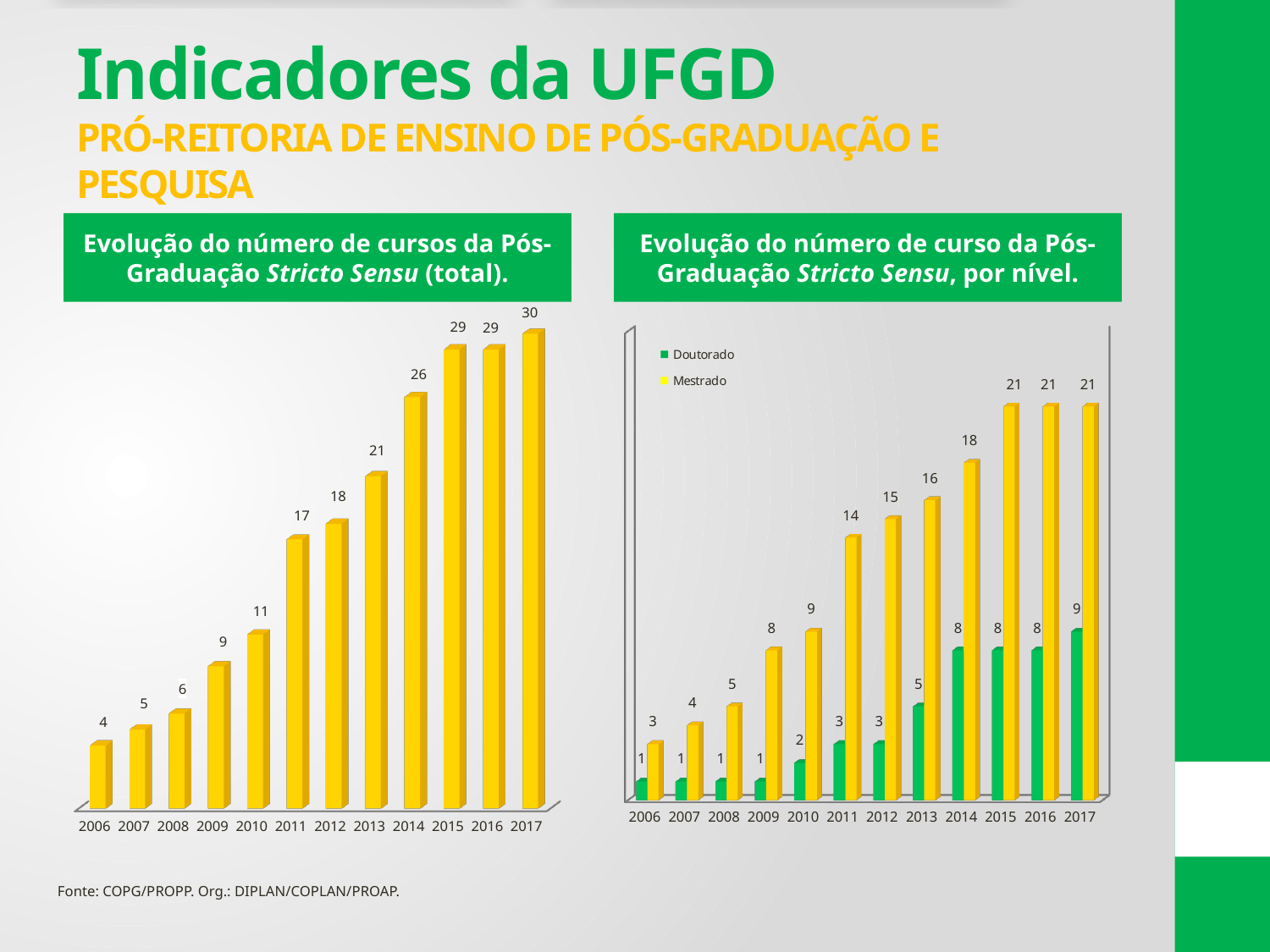
In the left chart (total courses), which year has the lowest value? 2006 In the right chart (por nível), how many series does the legend list? 2 In the left chart (total courses), what is the difference between the values for 2017 and 2006? 26 What type of chart is the left chart (total courses)? bar chart In the left chart (Evolução do número de cursos da Pós-Graduação Stricto Sensu (total)), what is the value for 2014? 26 In the right chart (por nível), what is the difference between the Mestrado and Doutorado values for 2017? 12 In the left chart (total courses), do the values generally rise or fall from 2006 to 2017? rise In the right chart (por nível), what is the Doutorado value for 2010? 2 In the left chart (total courses), how many years are shown on the x axis? 12 In the right chart (por nível), which is larger in 2011: Doutorado or Mestrado? Mestrado In the right chart (por nível), what is the Mestrado value for 2013? 16 In the left chart (total courses), which year has the highest value? 2017